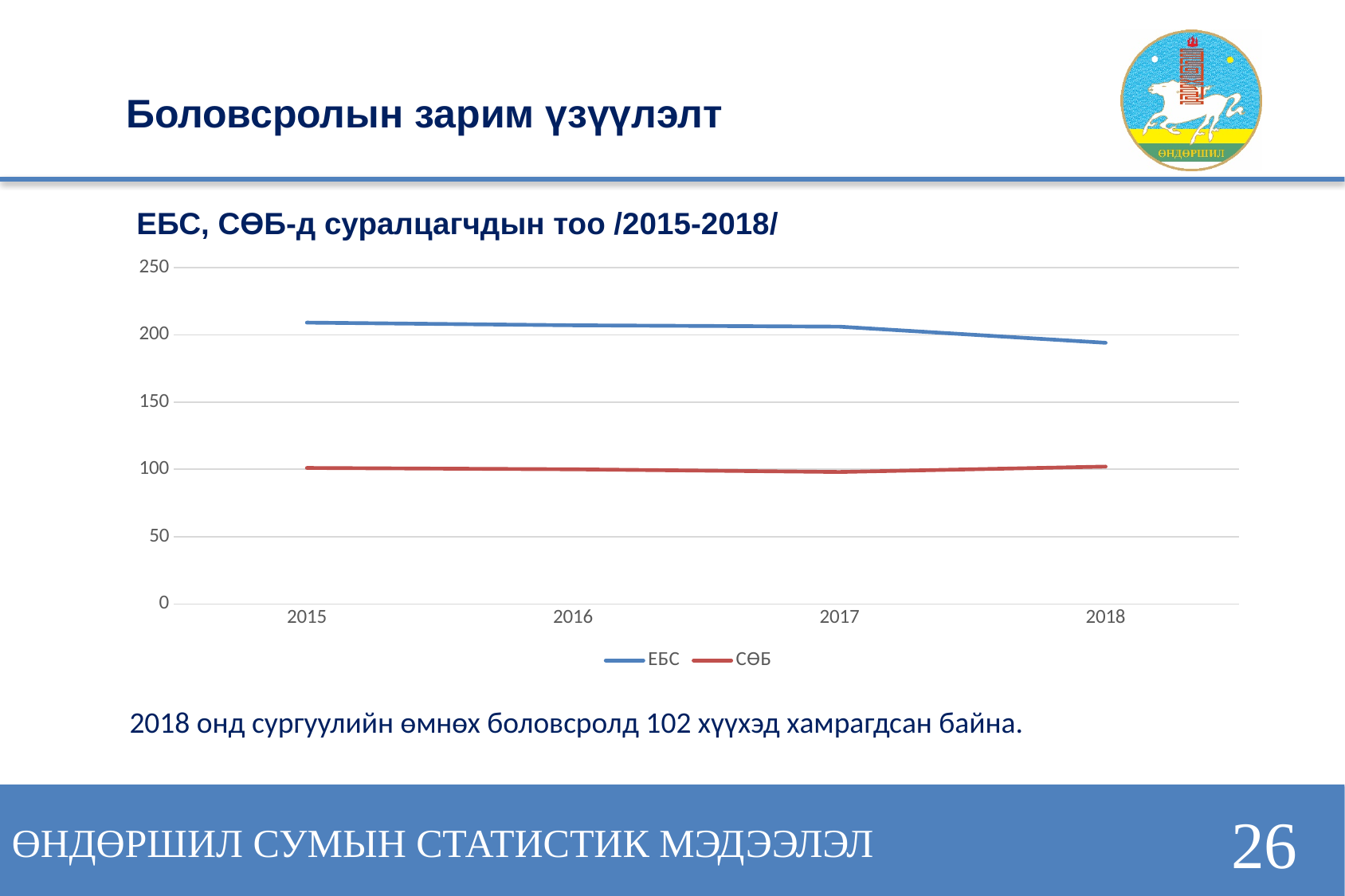
How many years are plotted along the x axis of the chart? 4 How many series does the chart legend list? 2 In which year is the ЕБС value lowest? 2018 Which series is drawn with the blue line? ЕБС Is the value for ЕБС in 2017 greater or less than 150? greater Is the value for ЕБС in 2015 greater or less than 200? greater Is the value for ЕБС in 2018 greater or less than 200? less In 2018, which series has the larger value, ЕБС or СӨБ? ЕБС What kind of chart is shown on the slide? line chart What is the title of the chart? ЕБС, СӨБ-д суралцагчдын тоо /2015-2018/ Does the ЕБС line rise or fall from 2015 to 2018? fall